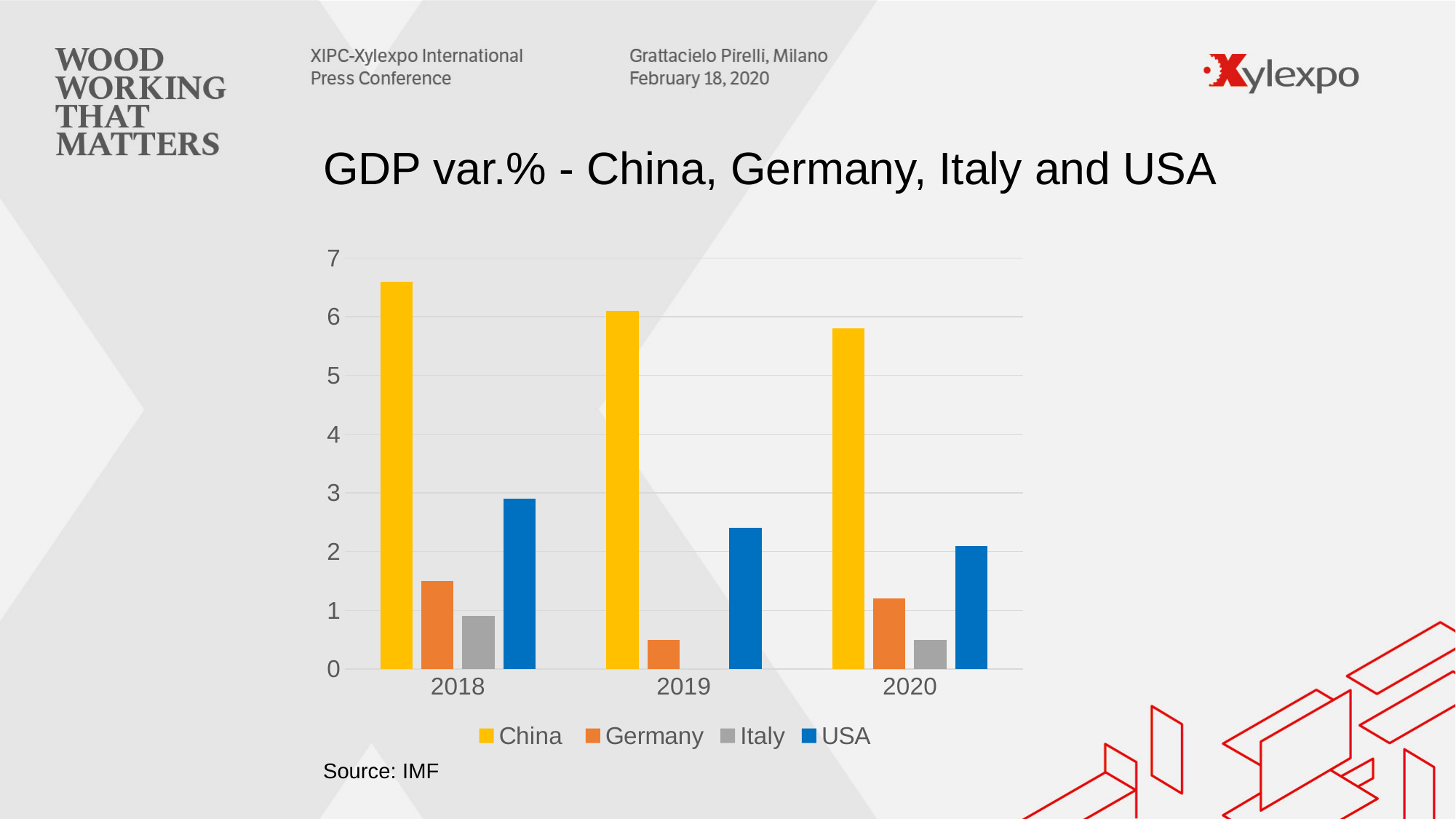
Which is larger, the value for USA in 2018 or the value for USA in 2020? USA in 2018 Is the value for USA in 2020 greater or less than 3? less Which country has the highest GDP variation in 2018? China Is the value for Germany in 2019 greater or less than 1? less How many years are shown on the x axis? 3 Which country has the lowest GDP variation in 2020? Italy Do the values for China rise or fall from 2018 to 2020? fall Is the value for China in 2018 greater or less than 6? greater How many series does the legend list? 4 What kind of chart is shown on the slide? bar chart Which series is shown in blue? USA What is the title of the chart? GDP var.% - China, Germany, Italy and USA